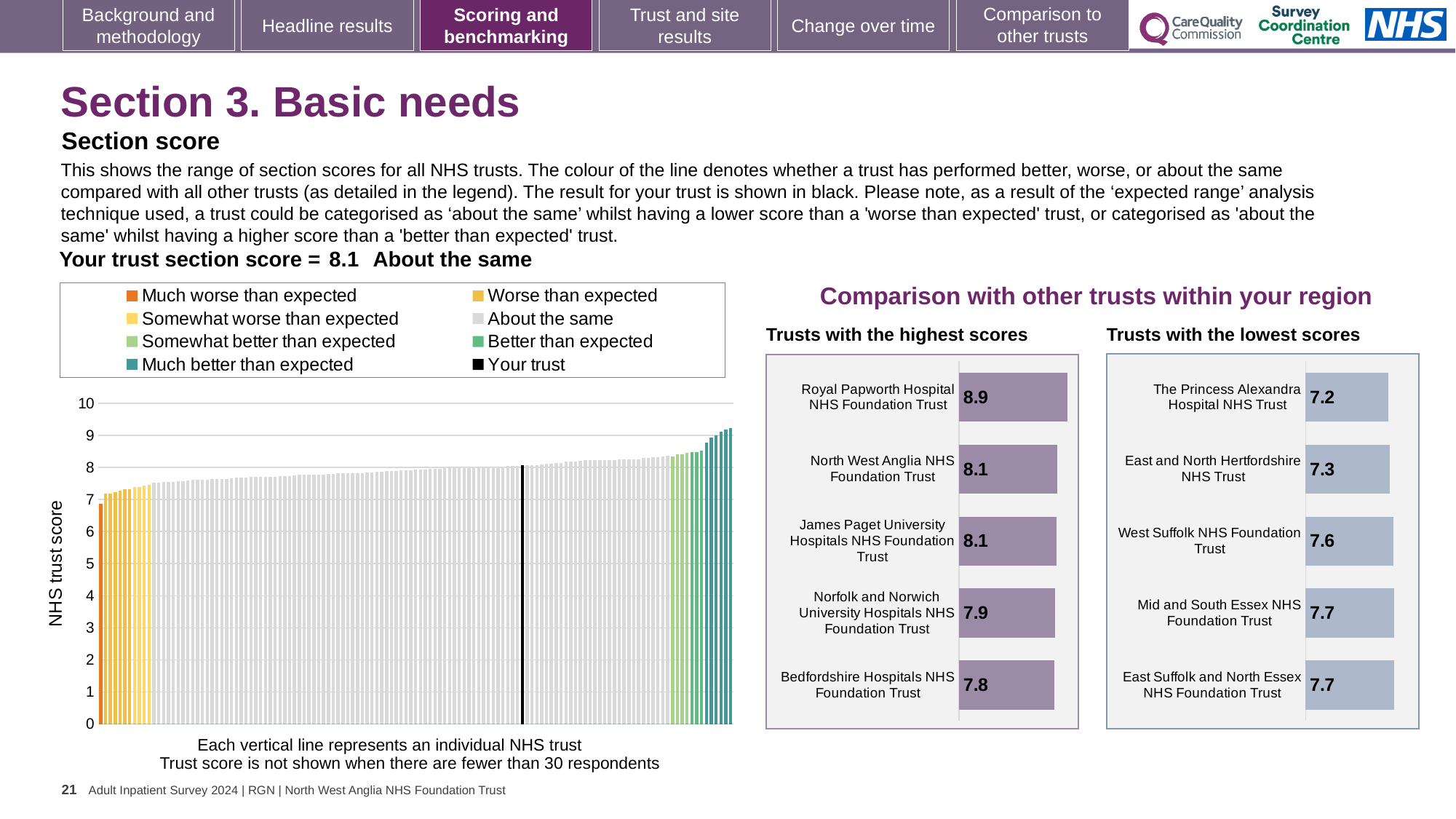
On the large chart on the left showing NHS trust scores, how many entries does the legend list? 8 On the 'Trusts with the lowest scores' chart, which trust has the lowest score? The Princess Alexandra Hospital NHS Trust On the 'Trusts with the lowest scores' chart, what is the score for The Princess Alexandra Hospital NHS Trust? 7.2 On the 'Trusts with the lowest scores' chart, what is the difference between the scores of West Suffolk NHS Foundation Trust and The Princess Alexandra Hospital NHS Trust? 0.4 On the large chart on the left showing NHS trust scores, what is the section score for your trust? 8.1 On the large chart on the left showing NHS trust scores, do the values rise or fall from left to right? rise On the 'Trusts with the highest scores' chart, what is the difference between the scores of Royal Papworth Hospital NHS Foundation Trust and Bedfordshire Hospitals NHS Foundation Trust? 1.1 On the 'Trusts with the lowest scores' chart, which has the higher score: West Suffolk NHS Foundation Trust or East and North Hertfordshire NHS Trust? West Suffolk NHS Foundation Trust On the 'Trusts with the highest scores' chart, how many trusts are listed? 5 What kind of chart is the 'Trusts with the highest scores' chart? bar chart On the 'Trusts with the highest scores' chart, what is the score for Royal Papworth Hospital NHS Foundation Trust? 8.9 On the 'Trusts with the highest scores' chart, which trust has the lowest score shown? Bedfordshire Hospitals NHS Foundation Trust